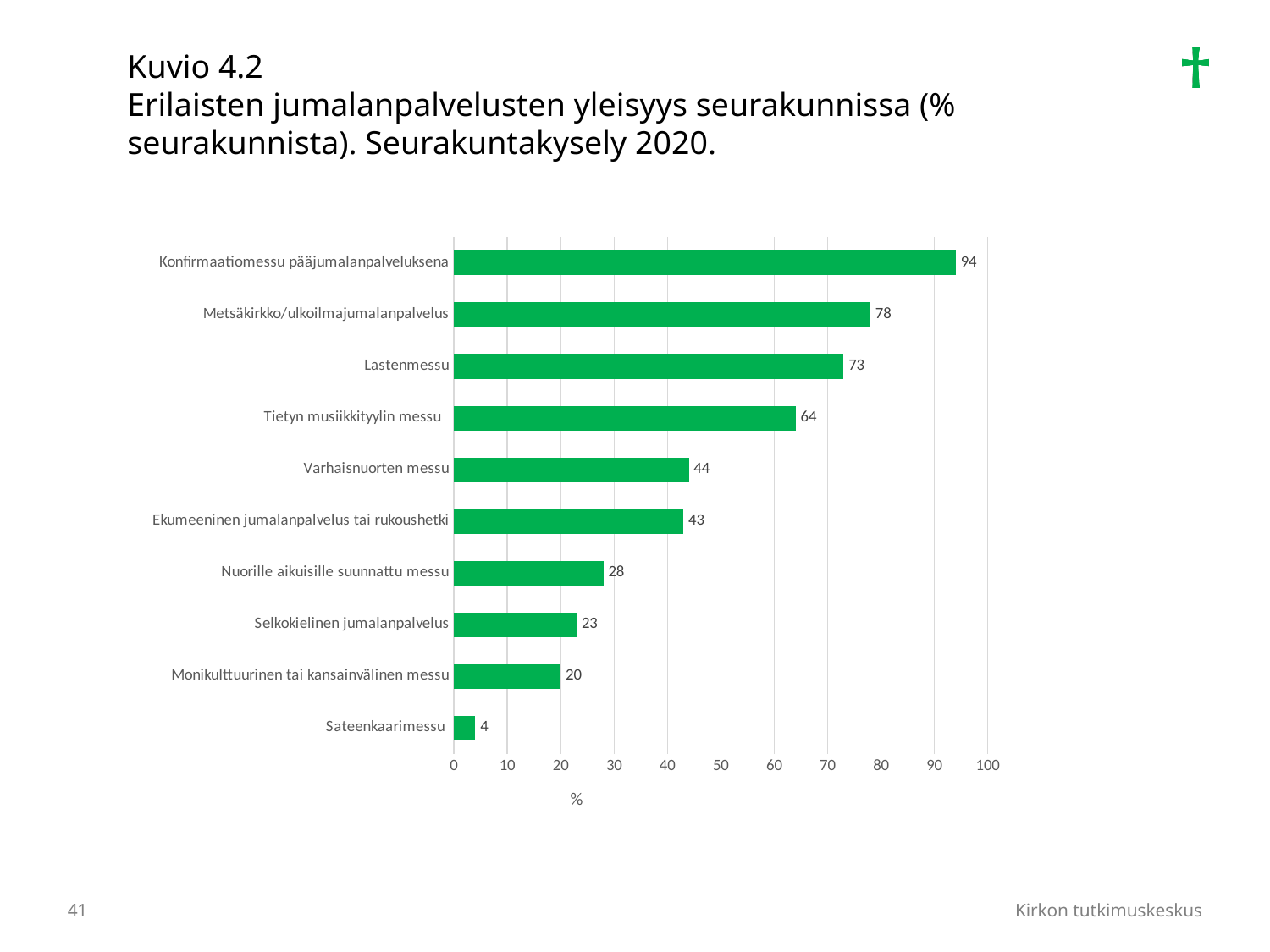
What is the difference between the values for Metsäkirkko/ulkoilmajumalanpalvelus and Tietyn musiikkityylin messu? 14 What is the value for Ekumeeninen jumalanpalvelus tai rukoushetki? 43 What is the value for Lastenmessu? 73 What is the difference between the values for Nuorille aikuisille suunnattu messu and Monikulttuurinen tai kansainvälinen messu? 8 What kind of chart is shown on the slide? bar chart Which category has the lowest value? Sateenkaarimessu Is the value for Tietyn musiikkityylin messu greater or less than 50? greater Which category has the highest value? Konfirmaatiomessu pääjumalanpalveluksena How many categories are shown in the chart? 10 Which is larger, the value for Varhaisnuorten messu or the value for Selkokielinen jumalanpalvelus? Varhaisnuorten messu What is the value for Selkokielinen jumalanpalvelus? 23 What is the label of the horizontal axis? %